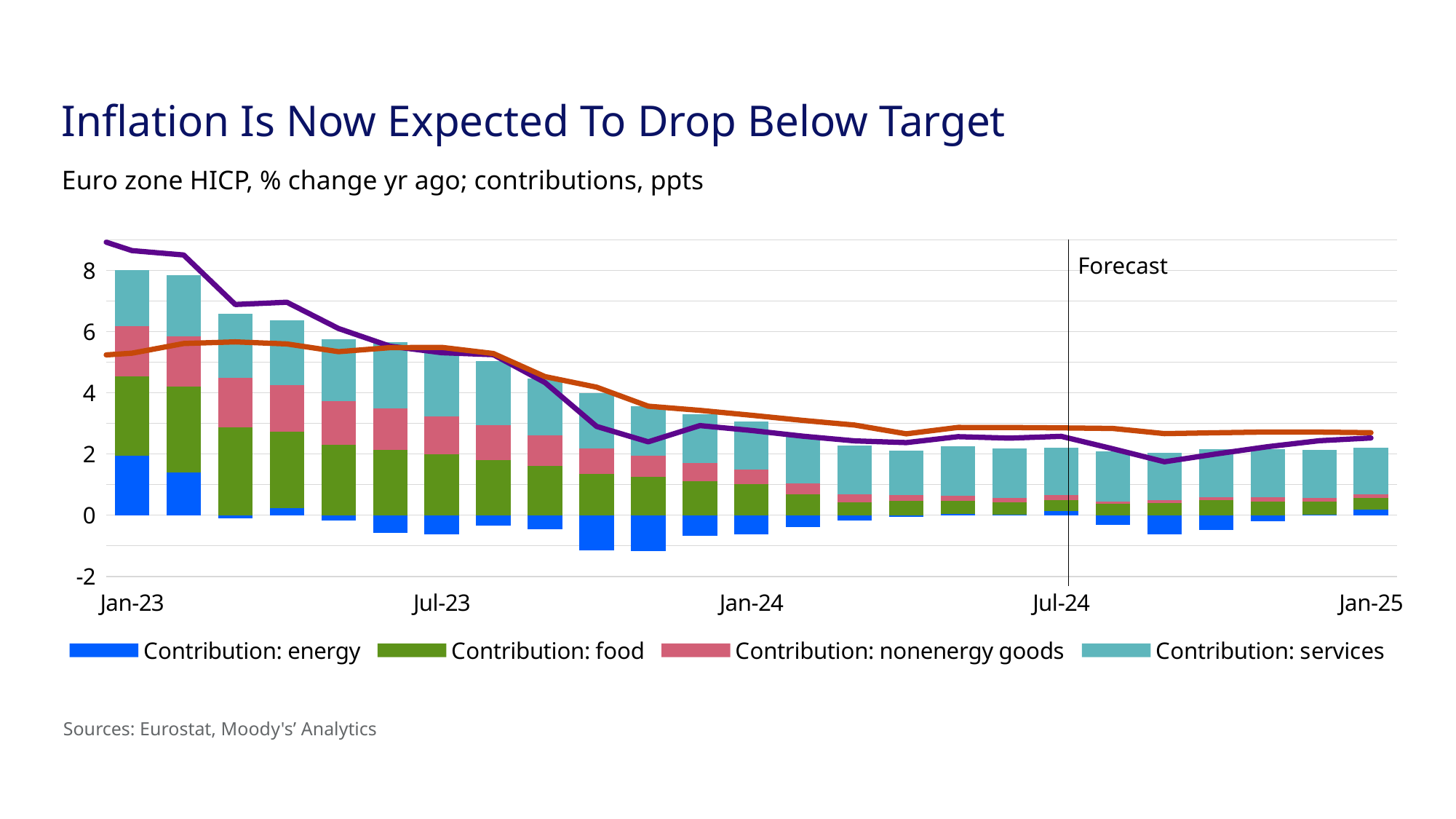
Is the value of the purple line at Jan-25 greater or less than 4? less Is the total height of the stacked bar at Jan-25 greater or less than 4? less At which x-axis label does the purple line reach its highest value? Jan-23 How many series does the legend list? 4 What is the title of the chart? Inflation Is Now Expected To Drop Below Target Is the value of the purple line at Jan-23 greater or less than 8? greater Which is larger, the total stacked bar at Jan-23 or at Jan-25? Jan-23 What kind of chart is shown on the slide? Stacked bar chart with line overlays Does the purple line rise or fall from Jan-23 to Jan-25? fall What label appears next to the vertical line near Jul-24? Forecast